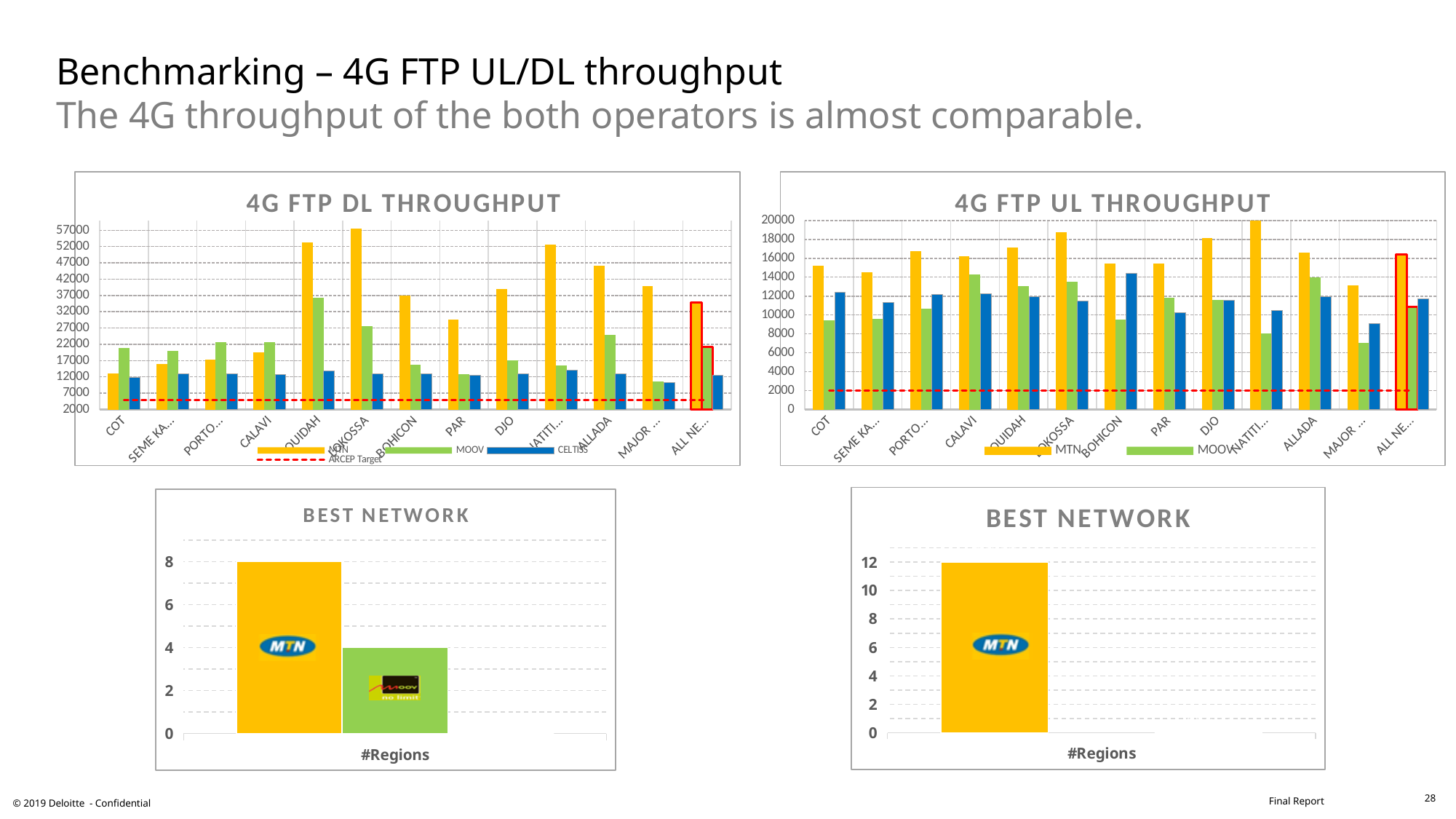
In the 4G FTP DL THROUGHPUT chart, which is larger for COT, the MTN value or the MOOV value? MOOV How many categories are shown on the x axis of the 4G FTP DL THROUGHPUT chart? 13 In the 4G FTP DL THROUGHPUT chart, which category has the highest MTN bar? LOKOSSA In the bottom-left BEST NETWORK chart, what is the difference between the MTN and MOOV values? 4 In the bottom-right BEST NETWORK chart, what is the value for MTN? 12 In the bottom-left BEST NETWORK chart, what is the value for MOOV? 4 In the 4G FTP UL THROUGHPUT chart, is the MOOV value for CALAVI greater or less than 12000? greater In the 4G FTP UL THROUGHPUT chart, which category has the highest MTN bar? NATITI... In the 4G FTP DL THROUGHPUT chart, is the MTN value for COT greater or less than 17000? less What kind of chart is the 4G FTP DL THROUGHPUT chart? combination bar and line chart How many entries does the legend of the 4G FTP DL THROUGHPUT chart list? 4 In the bottom-left BEST NETWORK chart, what is the value for MTN? 8